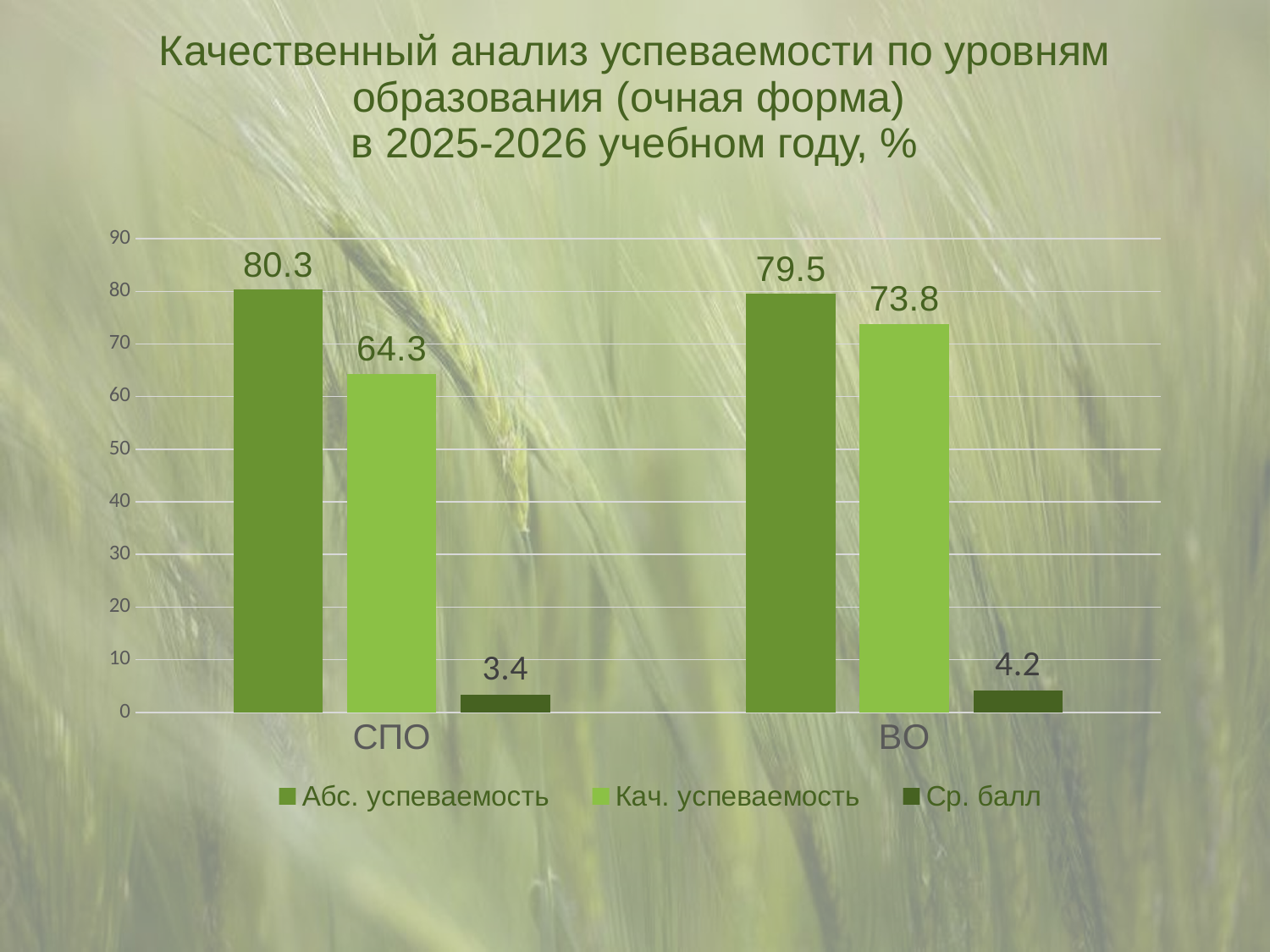
What is the value of Кач. успеваемость for ВО? 73.8 What is the value of Ср. балл for ВО? 4.2 Which category has the higher Кач. успеваемость value? ВО What is the difference in Кач. успеваемость between ВО and СПО? 9.5 Which category has the lower Ср. балл value? СПО Is the Абс. успеваемость value for СПО or for ВО larger? СПО How many series does the legend list? 3 How many categories are shown on the x axis? 2 What kind of chart is shown on the slide? Bar chart What is the difference between Абс. успеваемость and Кач. успеваемость for СПО? 16 What is the value of Ср. балл for СПО? 3.4 What is the value of Абс. успеваемость for СПО? 80.3